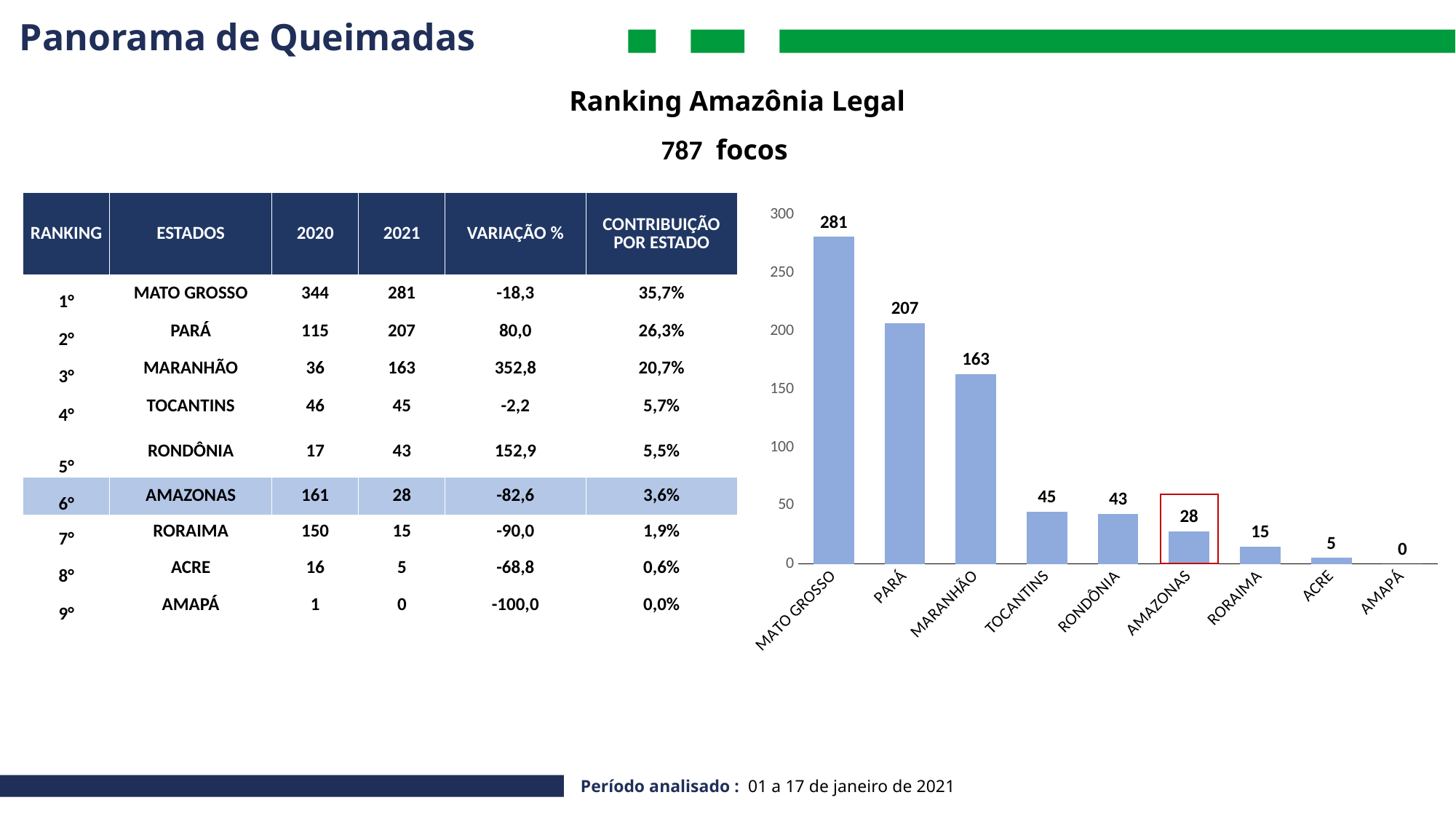
How many states are shown in the bar chart? 9 What is the value for MATO GROSSO in the bar chart? 281 Which has a larger value in the bar chart, TOCANTINS or RONDÔNIA? TOCANTINS Which bar in the chart is outlined with a red box? AMAZONAS Which state has the lowest value in the bar chart? AMAPÁ Do the values in the bar chart rise or fall from left to right? fall Is the value for PARÁ in the bar chart greater or less than 200? greater What is the difference between the values for PARÁ and MARANHÃO in the bar chart? 44 Which state has the highest value in the bar chart? MATO GROSSO What kind of chart is shown on the slide? bar chart What is the value for RONDÔNIA in the bar chart? 43 What is the value for MARANHÃO in the bar chart? 163